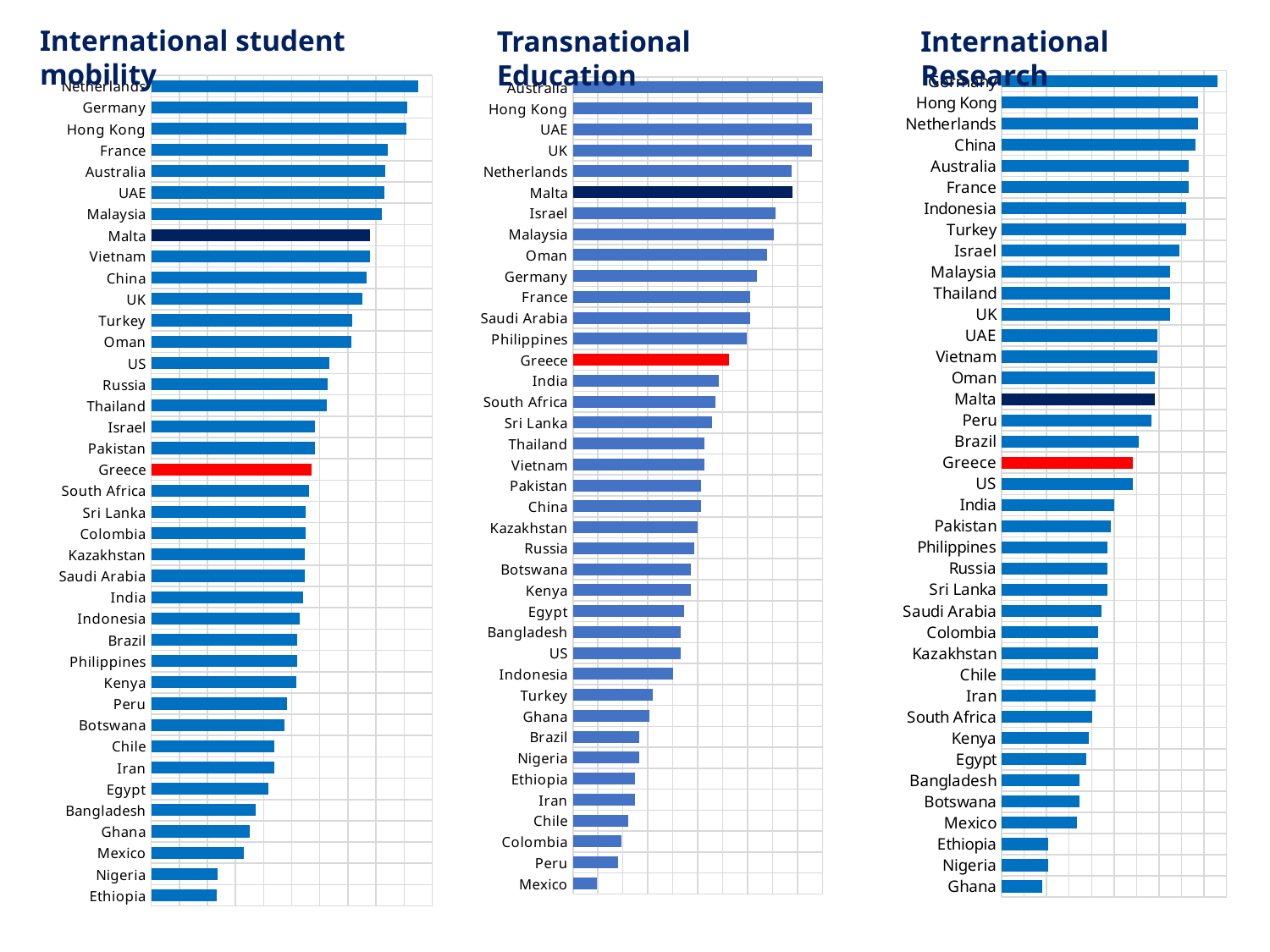
In the "Transnational Education" chart, which country has the highest value? Australia In the "Transnational Education" chart, which has the larger value, UK or Turkey? UK In the "International student mobility" chart, which country has the lowest value? Ethiopia In the "International Research" chart, which country's bar is coloured red? Greece In the "International student mobility" chart, which country has the highest value? Netherlands How many countries are listed in the "Transnational Education" chart? 39 How many charts are shown on the slide? 3 In the "Transnational Education" chart, which country has the lowest value? Mexico In the "International Research" chart, which has the larger value, Hong Kong or Ghana? Hong Kong In the "International student mobility" chart, which has the larger value, Germany or Greece? Germany What type of chart is the "International student mobility" chart? bar chart In the "International Research" chart, which country has the highest value? Germany